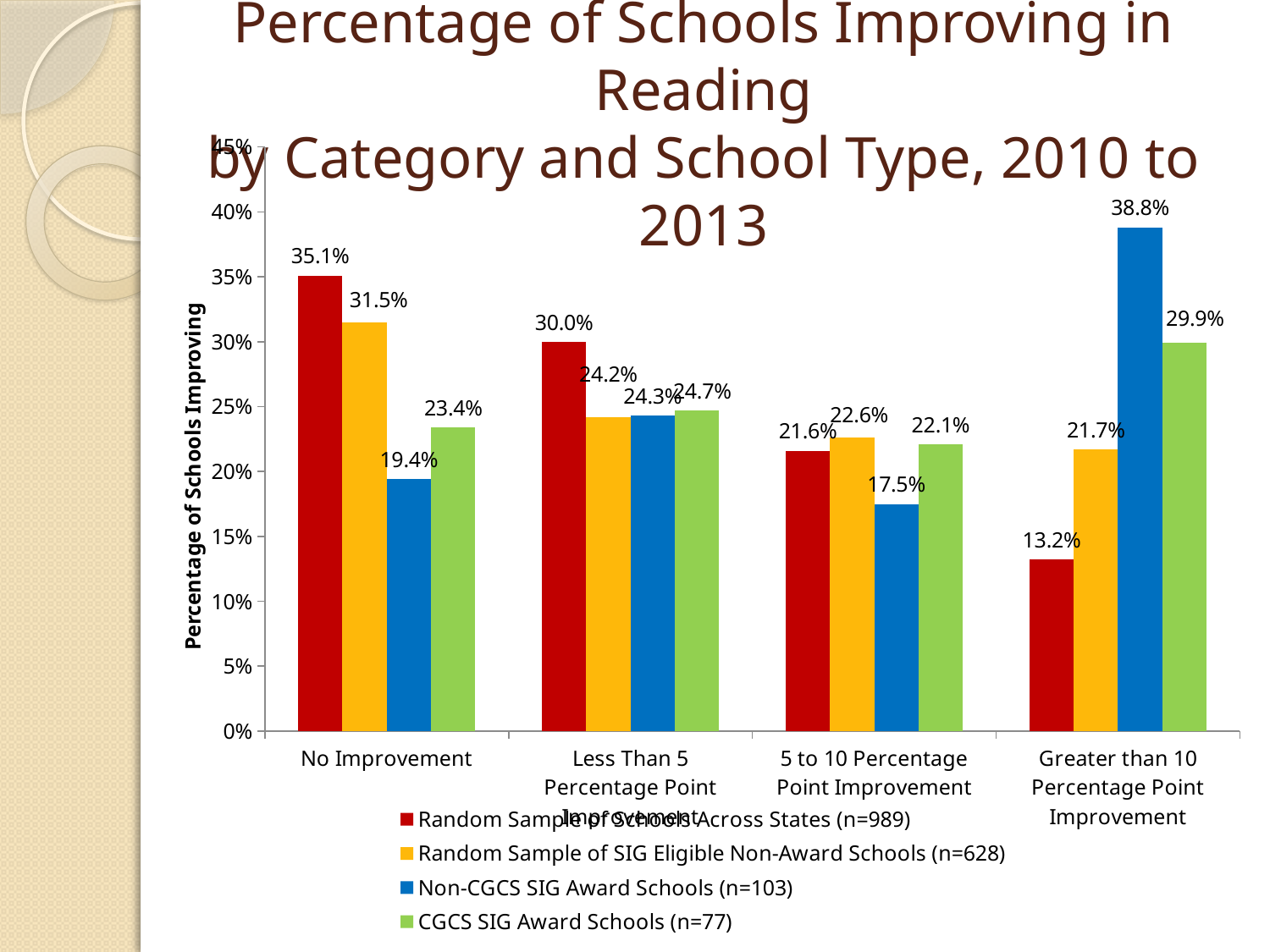
What percentage of CGCS SIG Award Schools (n=77) fell in the 5 to 10 Percentage Point Improvement category? 22.1% What is the value for the Random Sample of Schools Across States (n=989) in the No Improvement category? 35.1% In the Greater than 10 Percentage Point Improvement category, which is larger: the value for CGCS SIG Award Schools (n=77) or the Random Sample of SIG Eligible Non-Award Schools (n=628)? CGCS SIG Award Schools (n=77) Which school type has the highest value in the Greater than 10 Percentage Point Improvement category? Non-CGCS SIG Award Schools (n=103) Do the values for the Random Sample of Schools Across States (n=989) rise or fall from No Improvement to Greater than 10 Percentage Point Improvement? Fall How many series does the legend list? 4 What kind of chart is shown on the slide? Bar chart What percentage of Non-CGCS SIG Award Schools (n=103) showed Greater than 10 Percentage Point Improvement? 38.8% What is the label of the y axis? Percentage of Schools Improving What is the difference between the Random Sample of Schools Across States (n=989) and the CGCS SIG Award Schools (n=77) in the No Improvement category? 11.7% Which school type has the lowest value in the No Improvement category? Non-CGCS SIG Award Schools (n=103) How many improvement categories are shown on the x axis? 4